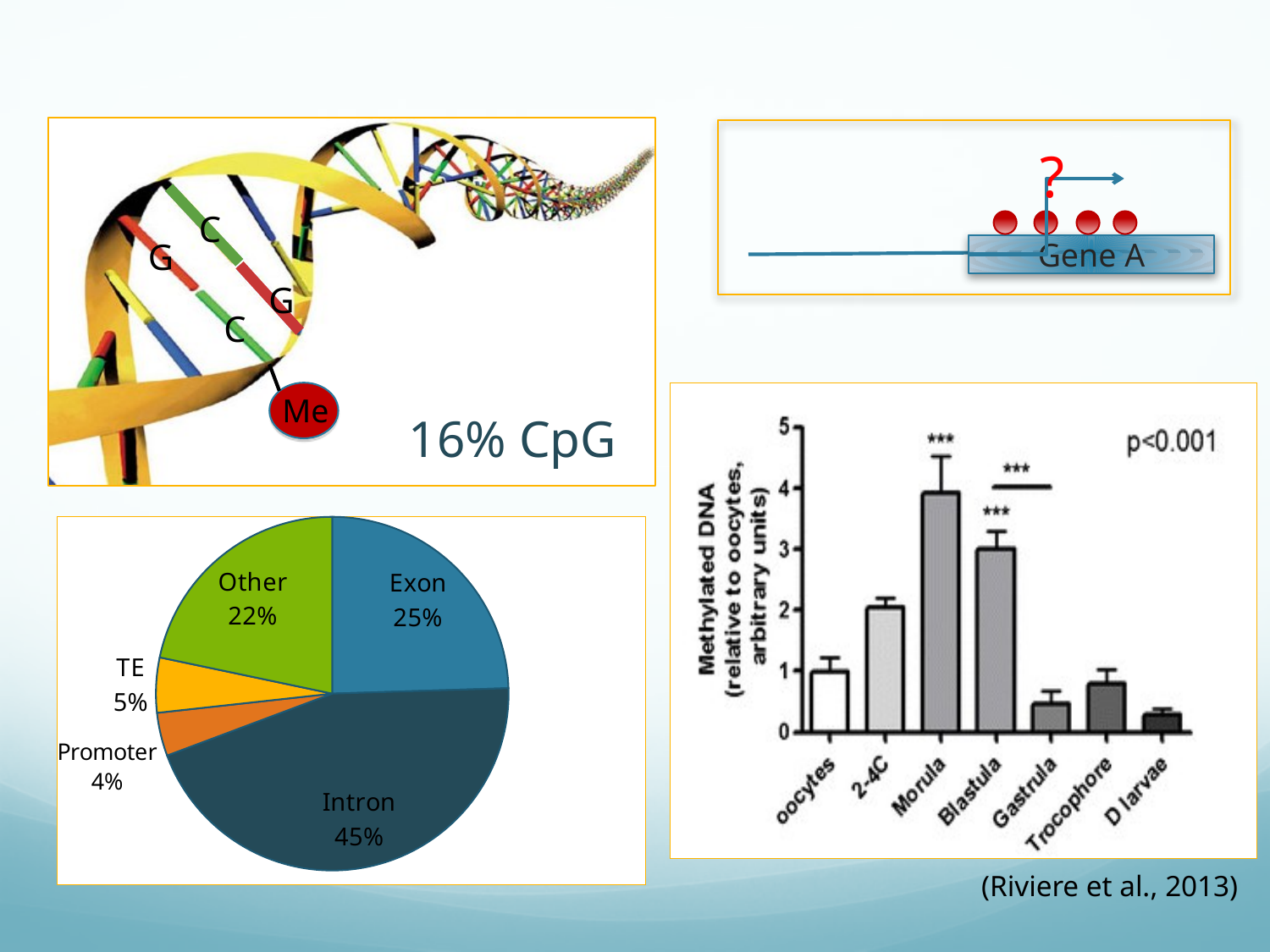
In the bar chart on the bottom right, is the value for Gastrula greater or less than 1? less What kind of chart is the chart on the bottom right of the slide? Bar chart In the bar chart on the bottom right, which stage has the lowest methylated DNA value? D larvae In the pie chart on the bottom left, what is the difference between the Exon and Other shares? 3% In the bar chart on the bottom right, which stage has the highest methylated DNA value? Morula In the pie chart on the bottom left, which is larger, the TE share or the Promoter share? TE In the pie chart on the bottom left, what share is labelled for Promoter? 4% In the pie chart on the bottom left, how many categories are shown? 5 In the pie chart on the bottom left, which category has the largest share? Intron In the pie chart on the bottom left, what share is labelled for Intron? 45% In the bar chart on the bottom right, how many stages are shown on the x axis? 7 In the pie chart on the bottom left, which category has the smallest share? Promoter